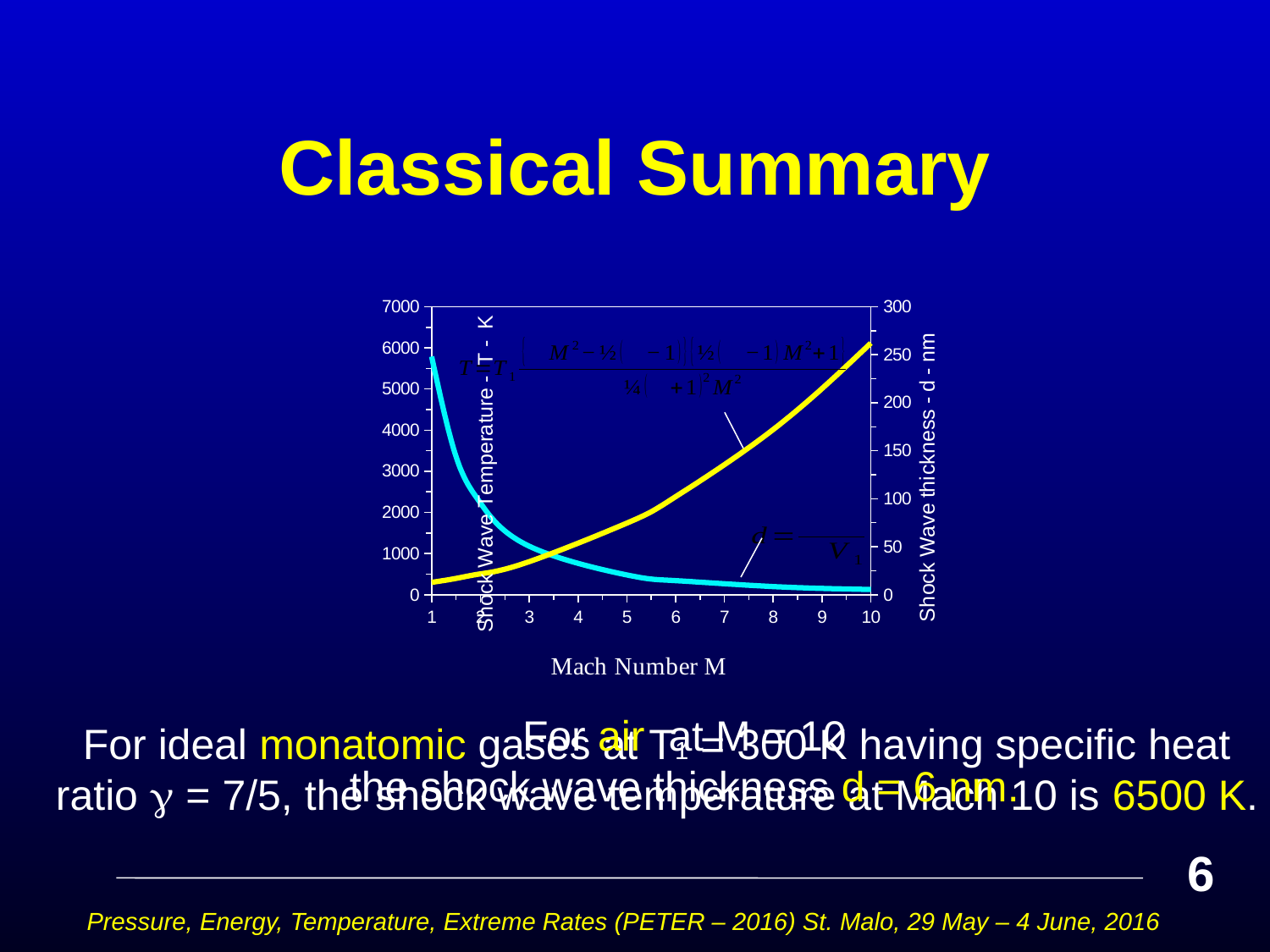
Is the shock wave temperature (yellow curve, left axis) at Mach 10 greater or less than 5000? greater What kind of chart is shown on the slide? line chart What is the label of the right-hand y axis of the chart? Shock Wave thickness - d - nm At which Mach number does the yellow curve reach its highest value? 10 Does the cyan curve (shock wave thickness) rise or fall as the Mach number increases? fall Is the shock wave thickness (cyan curve, right axis) at Mach 1 greater or less than 200? greater What is the label of the x axis of the chart? Mach Number M Is the shock wave thickness (cyan curve, right axis) at Mach 10 greater or less than 50? less Does the yellow curve (shock wave temperature) rise or fall as the Mach number increases? rise What is the highest value shown on the left y axis of the chart? 7000 How many Mach number tick values are labelled along the x axis? 10